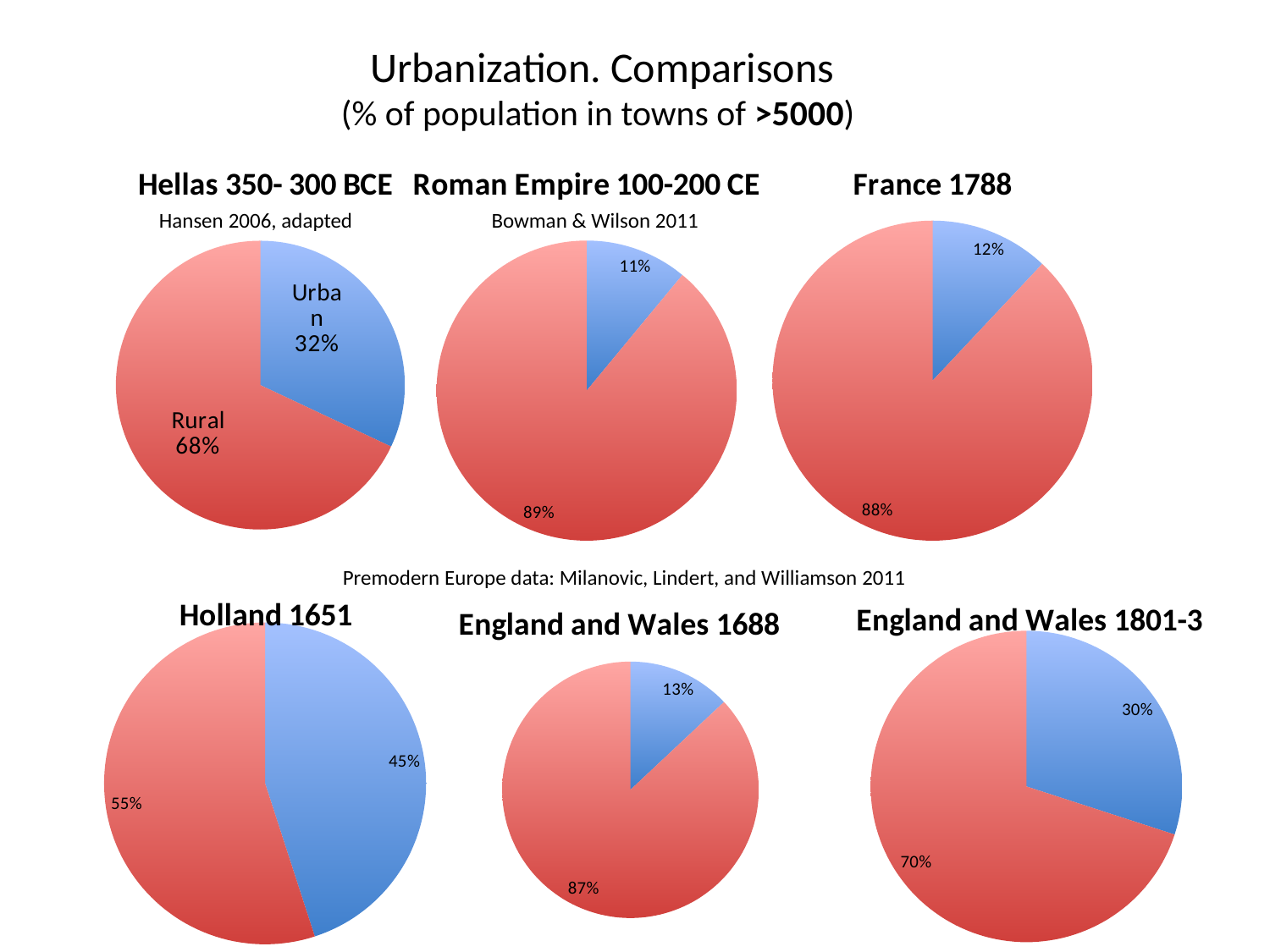
In the England and Wales 1688 chart, what percentage is shown for the red slice? 87% Which chart on the slide has the largest blue slice? Holland 1651 In the England and Wales 1801-3 chart, what percentage is shown for the blue slice? 30% In the France 1788 chart, what percentage is shown for the larger (red) slice? 88% In the Holland 1651 chart, what percentage is shown for the blue slice? 45% How many pie charts are on the slide? 6 Which chart on the slide has the smallest blue slice? Roman Empire 100-200 CE In the Hellas 350-300 BCE chart, what share of the pie is Urban? 32% In the Roman Empire 100-200 CE chart, what percentage is shown for the blue slice? 11% What is the difference between the blue slice in the England and Wales 1801-3 chart and the blue slice in the England and Wales 1688 chart? 17% What kind of charts are shown on the slide? Pie charts In the Hellas 350-300 BCE chart, what share of the pie is Rural? 68%